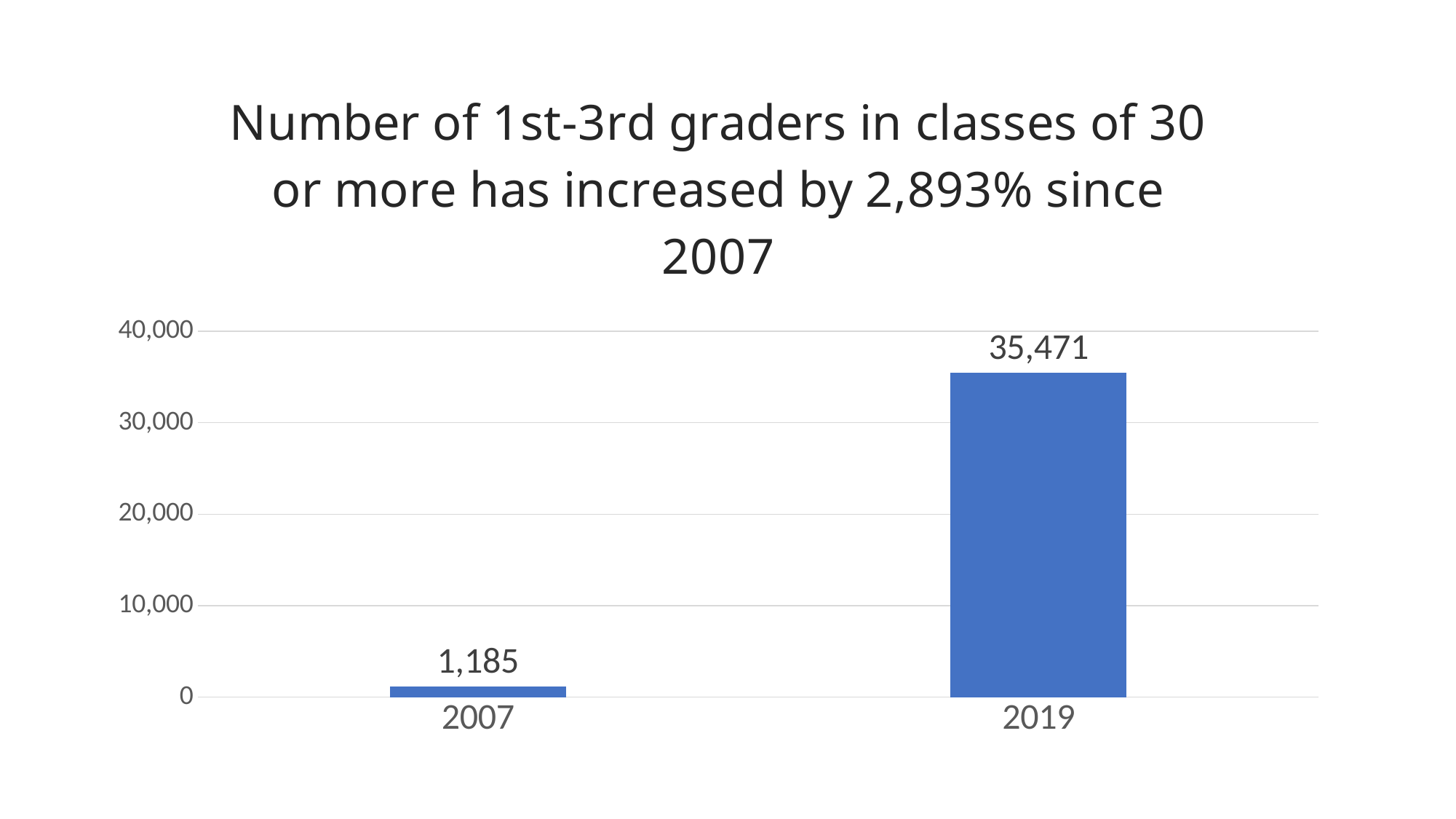
What is the value for 2019? 35,471 Which year has the lower value? 2007 Is the value for 2007 greater or less than 10,000? less Which year has the higher value? 2019 What is the difference between the 2019 and 2007 values? 34,286 What kind of chart is shown? bar chart Do the values rise or fall from 2007 to 2019? rise How many bars are shown in the chart? 2 What is the value for 2007? 1,185 What percentage increase does the chart title state? 2,893% Is the value for 2019 greater or less than 30,000? greater What is the highest value shown on the vertical axis? 40,000